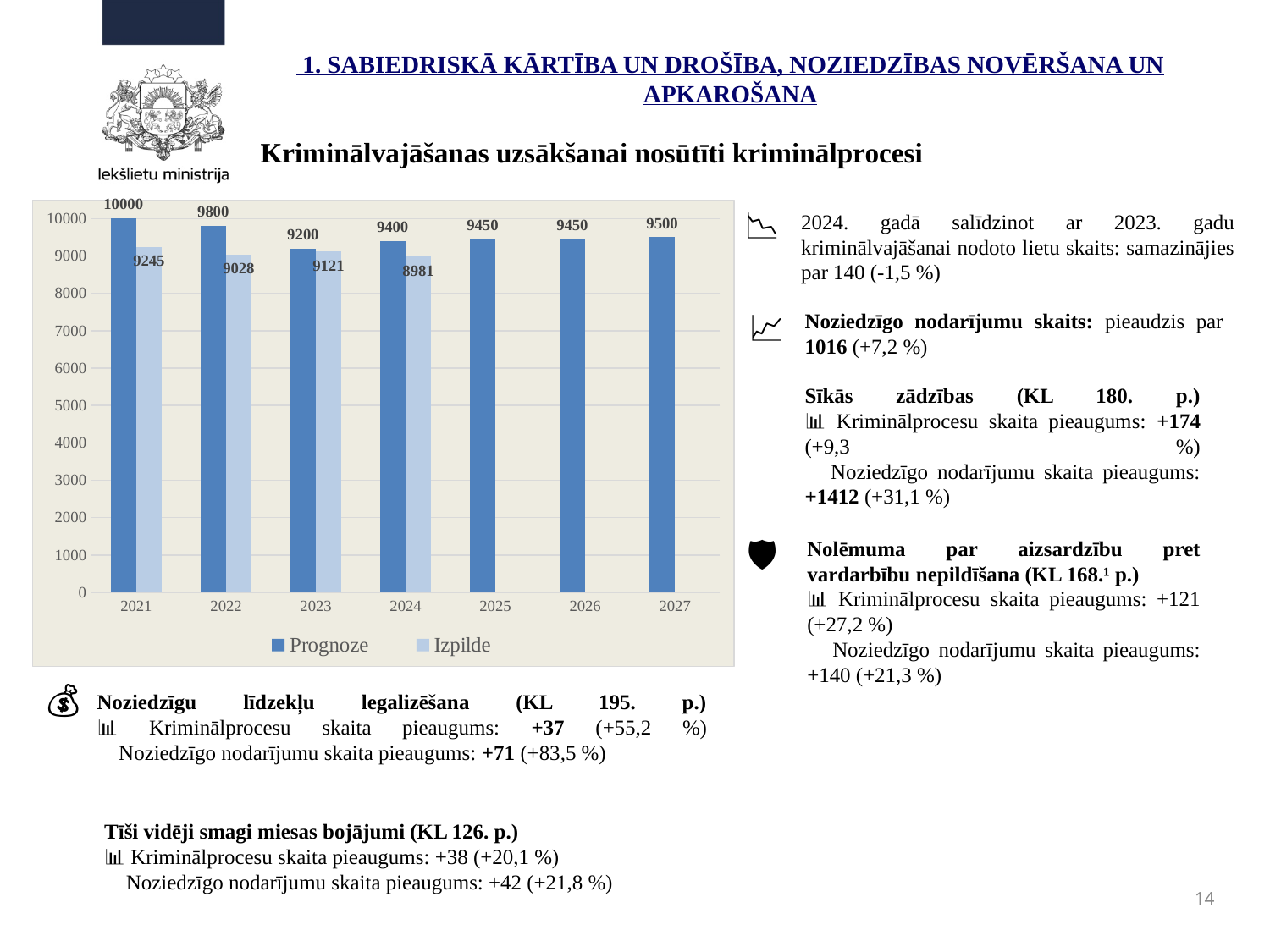
What kind of chart is shown on the slide? bar chart Which is larger in 2023, the Prognoze value or the Izpilde value? Prognoze Which year has the lowest Izpilde value? 2024 What is the Izpilde value for 2024? 8981 How many years are shown on the x axis? 7 What is the difference between the Prognoze and Izpilde values for 2022? 772 Which year has the highest Prognoze value? 2021 What is the Prognoze value for 2027? 9500 What is the Prognoze value for 2021? 10000 How many series does the legend list? 2 Does the Prognoze value rise or fall from 2021 to 2023? fall What is the title of the chart? Kriminālvajāšanas uzsākšanai nosūtīti kriminālprocesi